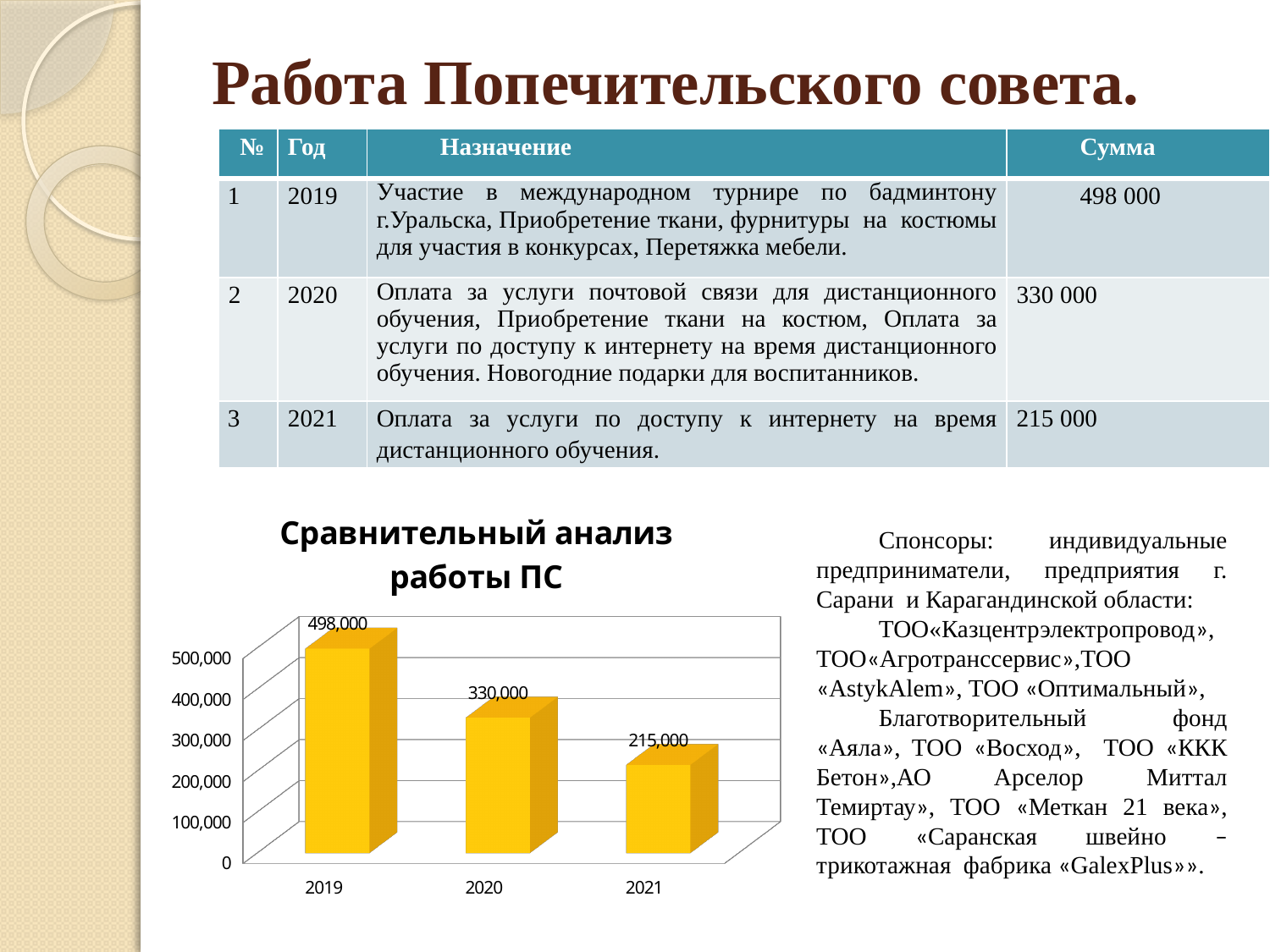
Do the values rise or fall from 2019 to 2021? fall Which year has the lowest value in the chart? 2021 Which is larger, the value for 2020 or the value for 2021? 2020 What is the value for 2019 in the chart? 498,000 What is the value for 2020 in the chart? 330,000 What is the value for 2021 in the chart? 215,000 What kind of chart is shown on the slide? bar chart What is the difference between the values for 2019 and 2020? 168,000 How many years are shown on the x axis of the chart? 3 Which year has the highest value in the chart? 2019 Is the value for 2020 greater or less than 400,000? less What is the difference between the values for 2019 and 2021? 283,000